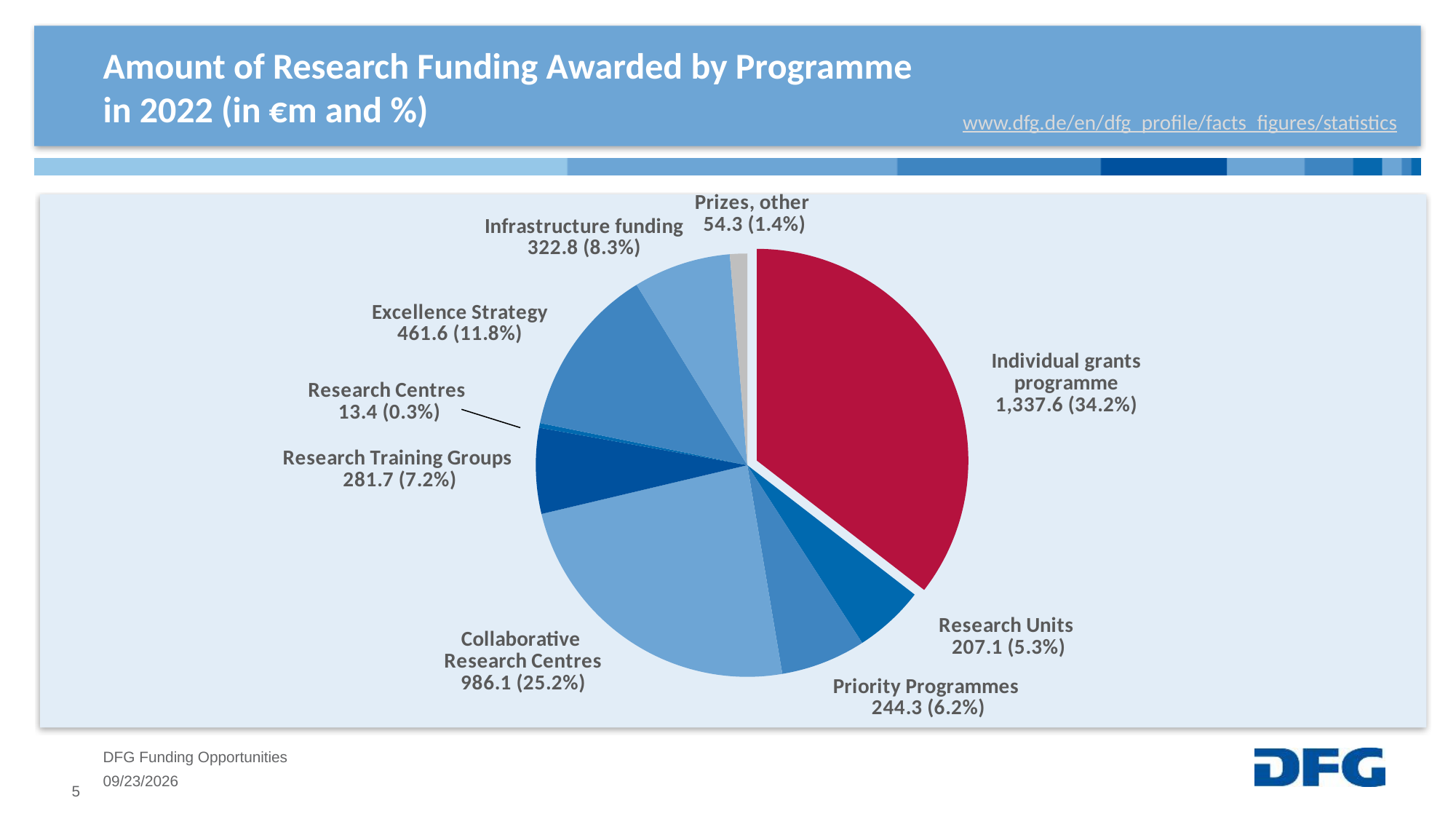
What is the difference in funding between Infrastructure funding and Research Training Groups? 41.1 Which received more funding, Priority Programmes or Research Units? Priority Programmes What is the value shown for Excellence Strategy? 461.6 How many programme categories are shown in the pie chart? 9 Which slice of the pie chart is coloured red? Individual grants programme What share of the funding went to Collaborative Research Centres? 25.2% How much funding was awarded to the Individual grants programme in 2022? 1,337.6 What percentage share is shown for Prizes, other? 1.4% Which programme received the largest amount of funding? Individual grants programme What kind of chart is shown on the slide? pie chart What is the difference in percentage share between the Individual grants programme and Collaborative Research Centres? 9.0% Which programme received the smallest amount of funding? Research Centres